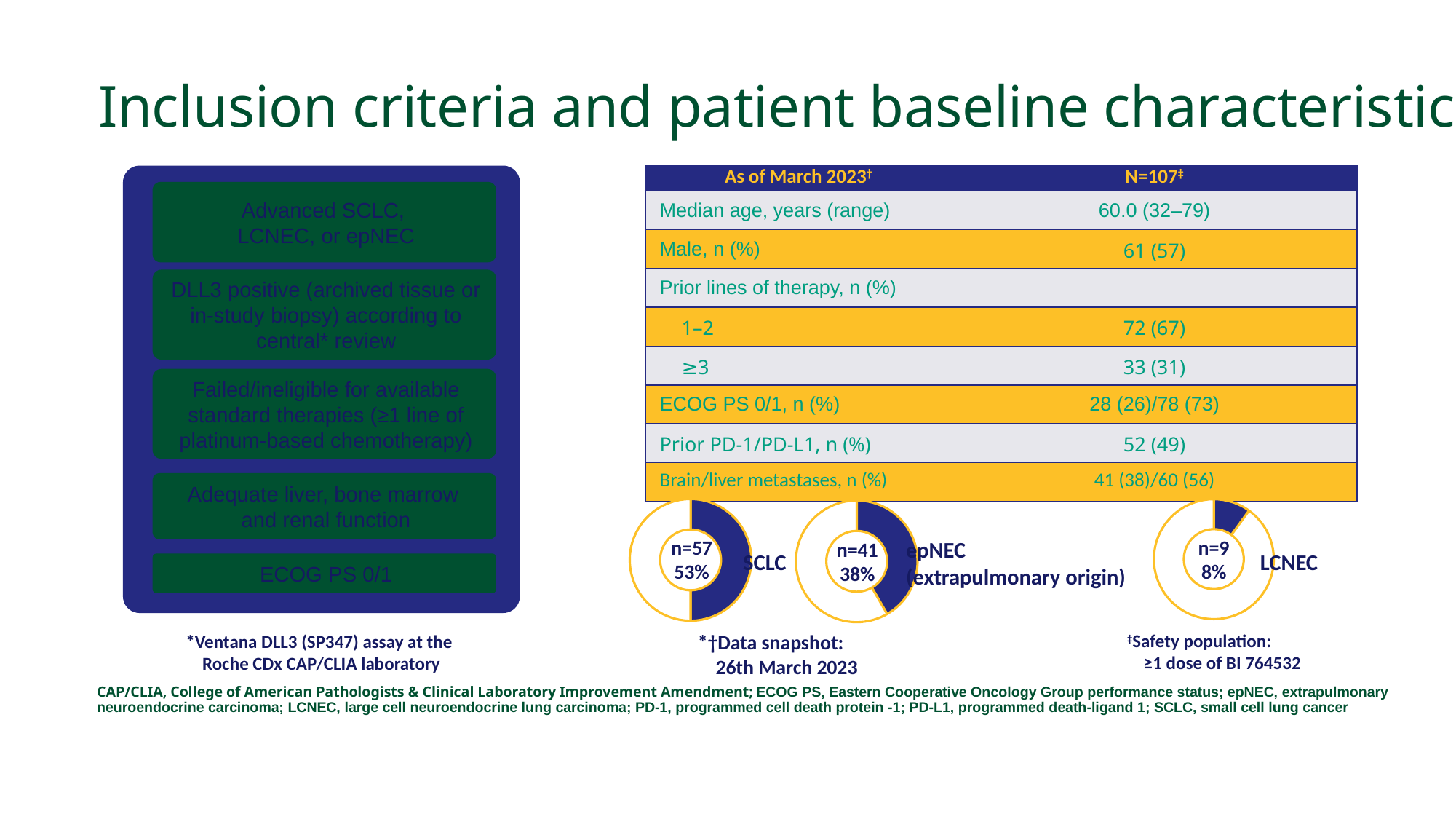
Comparing the SCLC and epNEC donut charts, which shows the larger percentage? SCLC What share of patients does the SCLC donut chart show? 53% Across the three donut charts (SCLC, epNEC, LCNEC), which tumour type has the smallest number of patients? LCNEC How many donut charts are shown at the bottom of the slide? 3 In the epNEC (extrapulmonary origin) donut chart, what percentage is shown? 38% What is the combined number of patients across the SCLC (n=57), epNEC (n=41) and LCNEC (n=9) donut charts? 107 In the LCNEC donut chart, how many patients (n) are shown? n=9 What is the difference in patient numbers between the SCLC donut chart (n=57) and the epNEC donut chart (n=41)? 16 What share of patients does the LCNEC donut chart show? 8% What kind of chart is used to show the SCLC, epNEC and LCNEC patient proportions at the bottom of the slide? Donut (pie) chart In the SCLC donut chart, how many patients (n) are shown? n=57 Across the three donut charts (SCLC, epNEC, LCNEC), which tumour type has the largest number of patients? SCLC